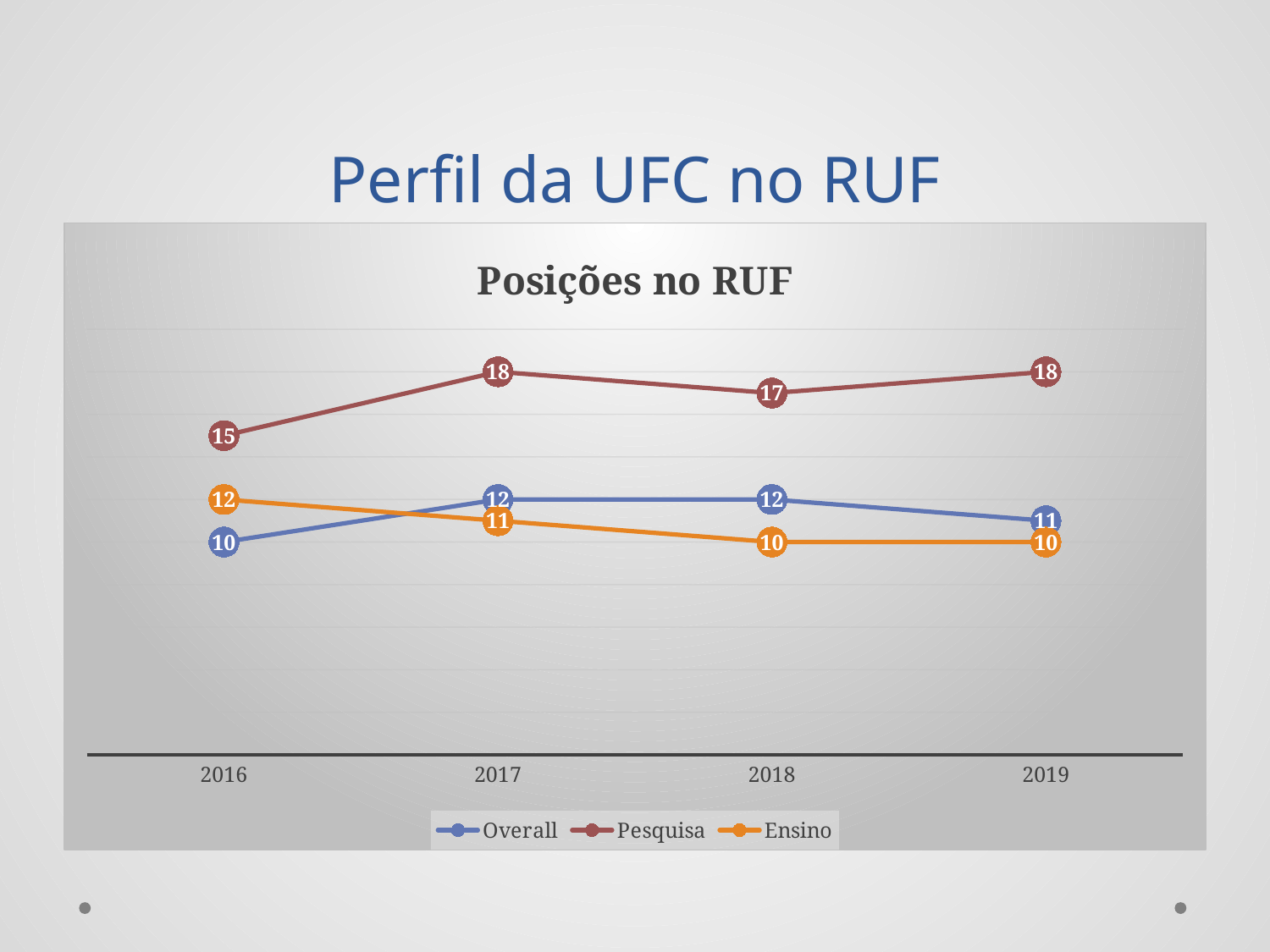
What kind of chart is shown? Line chart What is the value for Overall in 2016? 10 In which year is the Pesquisa value lowest? 2016 How many series does the legend list? 3 What is the difference between the Pesquisa and Overall values in 2018? 5 Does the Ensino series rise or fall from 2016 to 2019? Fall What is the value for Pesquisa in 2017? 18 In which year is the Ensino value highest? 2016 What is the value for Ensino in 2019? 10 Which is larger in 2016, the Overall value or the Ensino value? Ensino What is the value for Overall in 2019? 11 How many years are shown on the x axis? 4